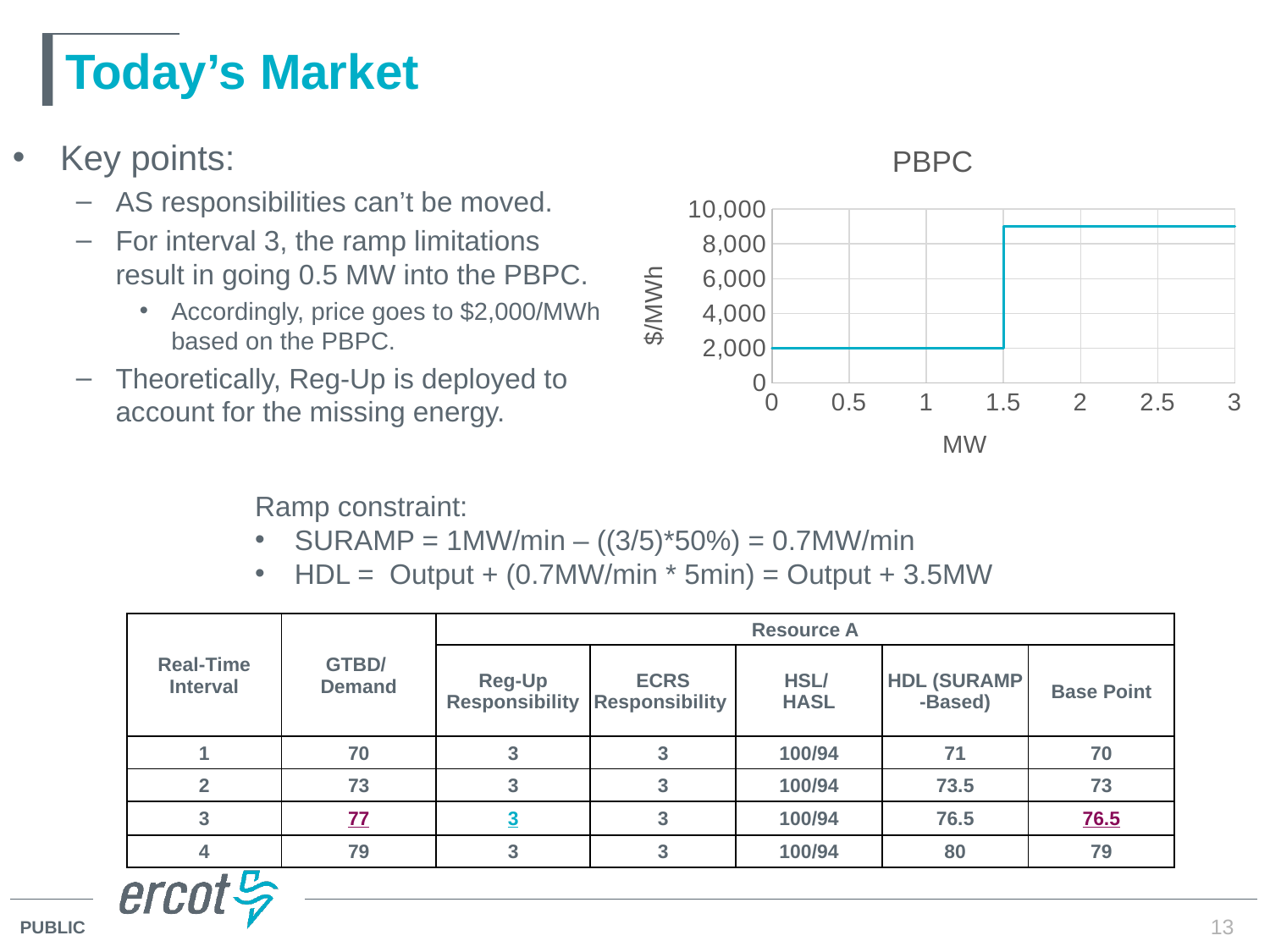
On the PBPC chart, what is the $/MWh value at 1 MW? 2,000 What is the label of the y axis on the PBPC chart? $/MWh On the PBPC chart, is the value at 0.5 MW greater or less than 4,000? less On the PBPC chart, what is the $/MWh value at 0.5 MW? 2,000 What kind of chart is the PBPC chart? line chart On the PBPC chart, is the value at 2 MW greater or less than 8,000? greater On the PBPC chart, is the value at 2.5 MW greater or less than 10,000? less What is the title of the chart on the slide? PBPC On the PBPC chart, which is larger: the value at 1 MW or the value at 2 MW? 2 MW On the PBPC chart, do the values rise or fall as MW increases from 0 to 3? rise On the PBPC chart, at what MW value does the price step up? 1.5